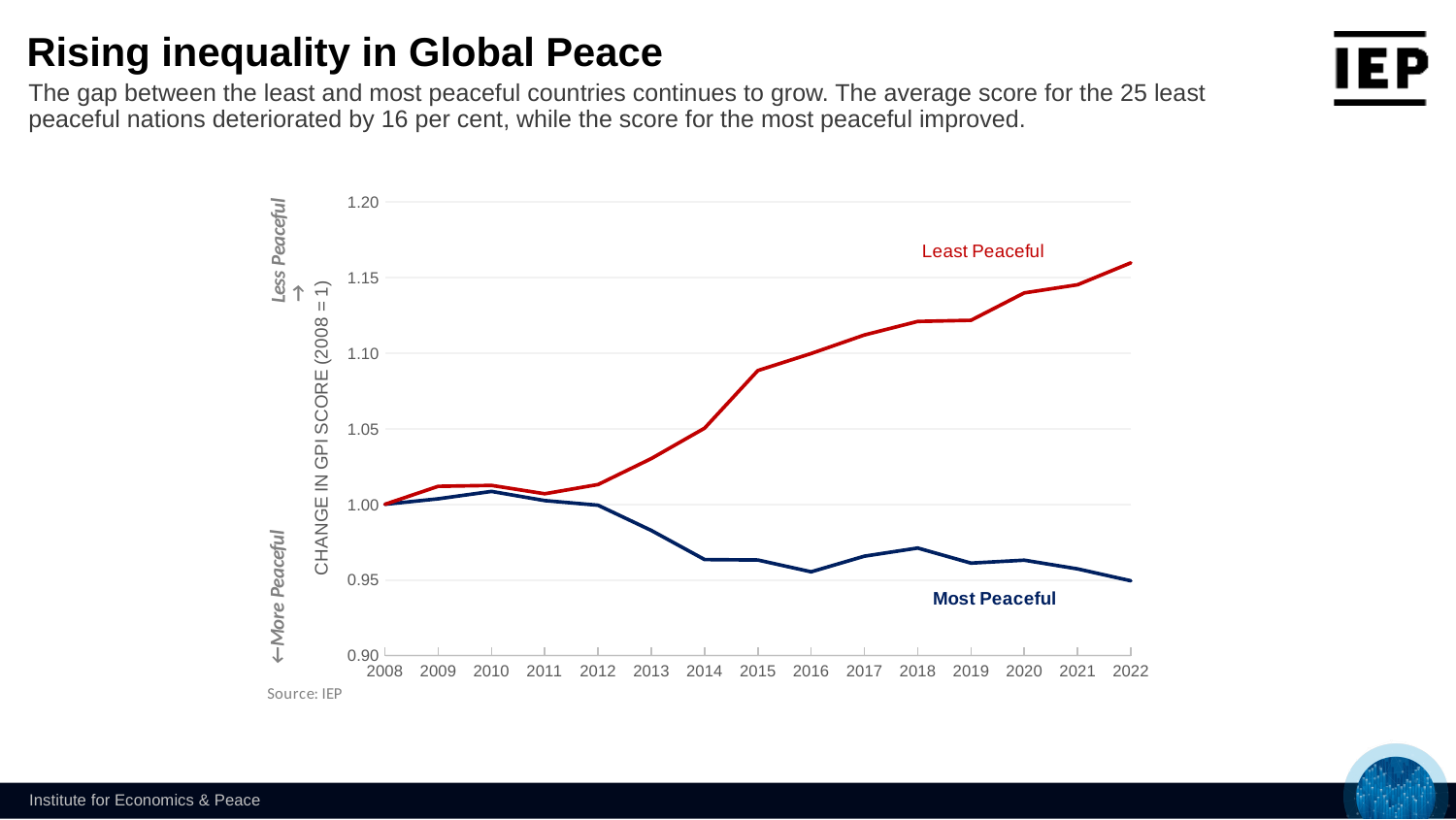
What is the value of the Least Peaceful series in 2008? 1.00 How many data series are plotted on the chart? 2 In 2022, which series has the higher value, Least Peaceful or Most Peaceful? Least Peaceful Does the Least Peaceful series rise or fall from 2008 to 2022? Rise Is the value for Least Peaceful in 2022 greater or less than 1.10? greater What is the value of the Most Peaceful series in 2008? 1.00 What is the title of the y axis on the chart? CHANGE IN GPI SCORE (2008 = 1) What type of chart is shown on the slide? Line chart How many years are shown along the x axis of the chart? 15 In which year does the Least Peaceful series reach its highest value? 2022 Does the Most Peaceful series rise or fall from 2008 to 2022? Fall Is the value for Most Peaceful in 2014 greater or less than 1.00? less